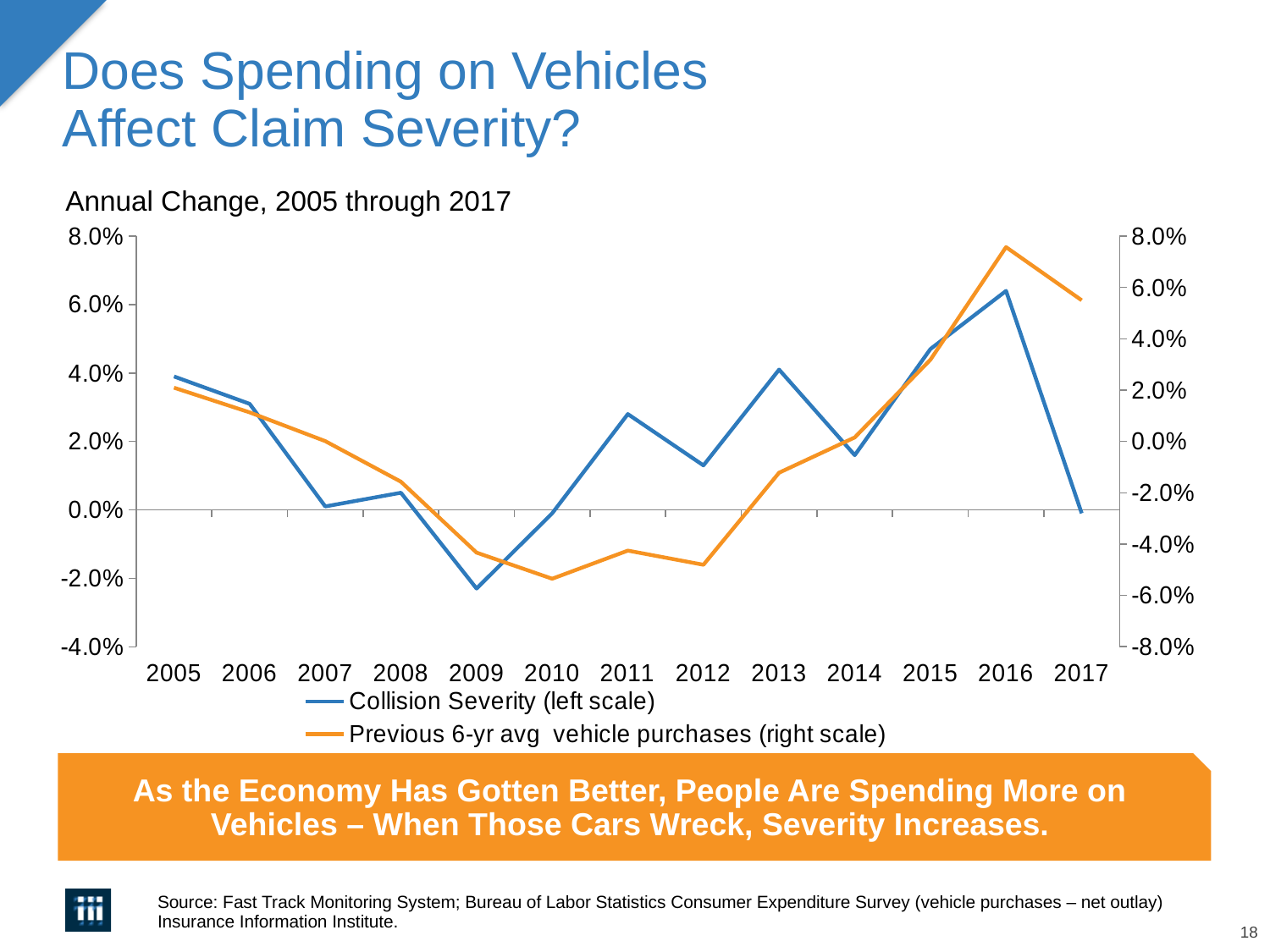
In which year is Collision Severity highest? 2016 Is the Previous 6-yr avg vehicle purchases value for 2010 greater or less than -4.0% on the right scale? less Is the Collision Severity value for 2009 greater or less than -2.0%? less Is the Collision Severity value for 2016 greater or less than 6.0%? greater In which year is the Previous 6-yr avg vehicle purchases series highest? 2016 How many years are plotted along the x axis? 13 What kind of chart is shown on the slide? Line chart Does Collision Severity rise or fall from 2016 to 2017? Fall In which year is Collision Severity lowest? 2009 Which series is plotted on the right scale according to the legend? Previous 6-yr avg vehicle purchases Which is larger, Collision Severity in 2005 or in 2007? 2005 How many series does the legend list? 2